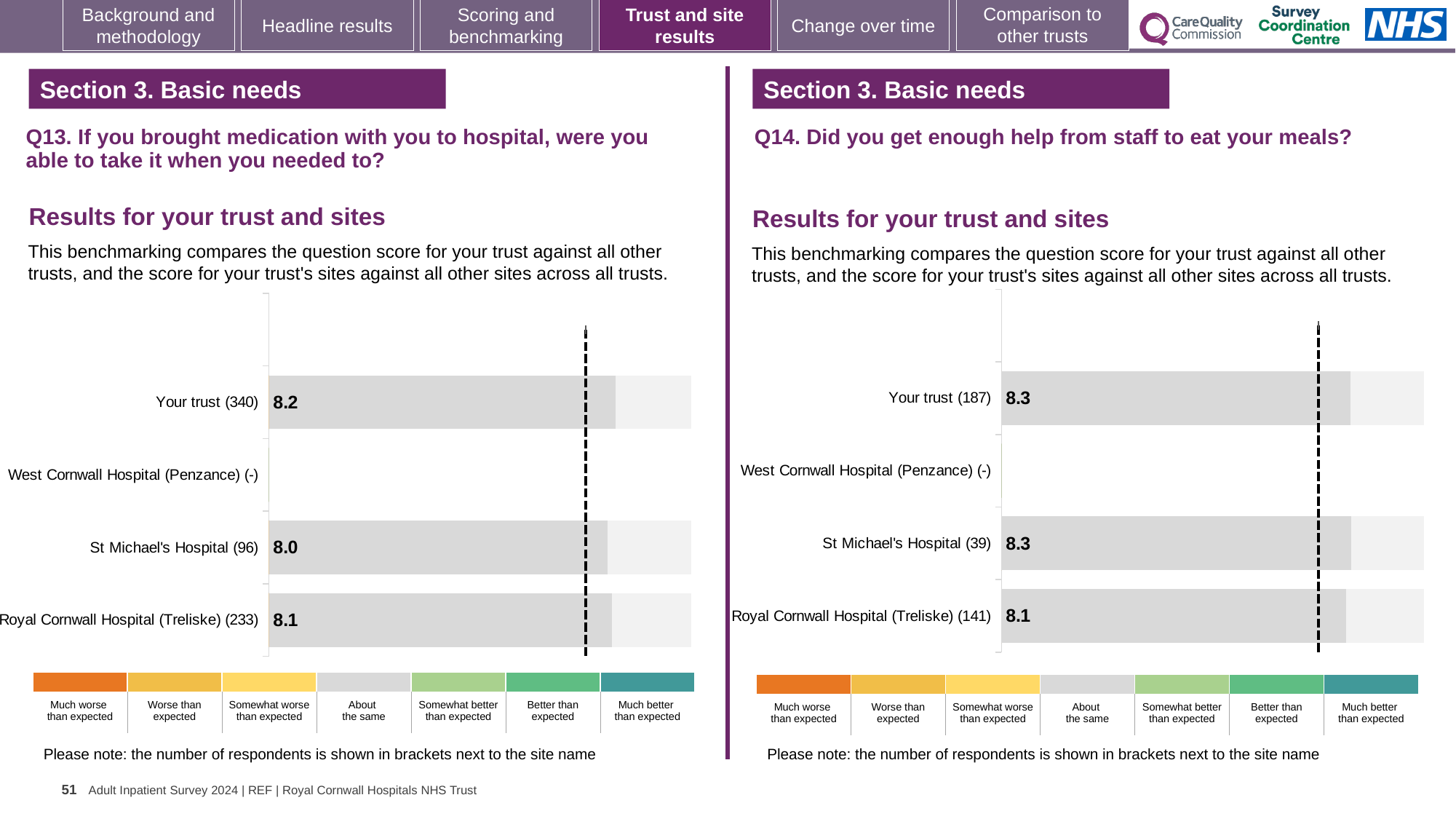
In the Q13 chart on the left, what is the score for St Michael's Hospital? 8.0 In the Q14 chart on the right, how many respondents are shown in brackets for Your trust? 187 In the Q13 chart on the left, which site has the lowest score? St Michael's Hospital In the Q14 chart on the right, is the score for St Michael's Hospital larger or smaller than the score for Royal Cornwall Hospital (Treliske)? larger What kind of chart is used for the Q13 results on the left? Bar chart In the Q13 chart on the left, what is the difference between the score for Your trust and the score for St Michael's Hospital? 0.2 In the Q14 chart on the right, which of the labelled bars has the lowest score? Royal Cornwall Hospital (Treliske) In the Q13 chart on the left, what is the score for Your trust? 8.2 How many categories (rows) are listed on the y axis of the Q13 chart on the left? 4 In the Q13 chart on the left, what is the score for Royal Cornwall Hospital (Treliske)? 8.1 In the Q14 chart on the right, what is the score for Your trust? 8.3 In the Q14 chart on the right, what is the score for Royal Cornwall Hospital (Treliske)? 8.1